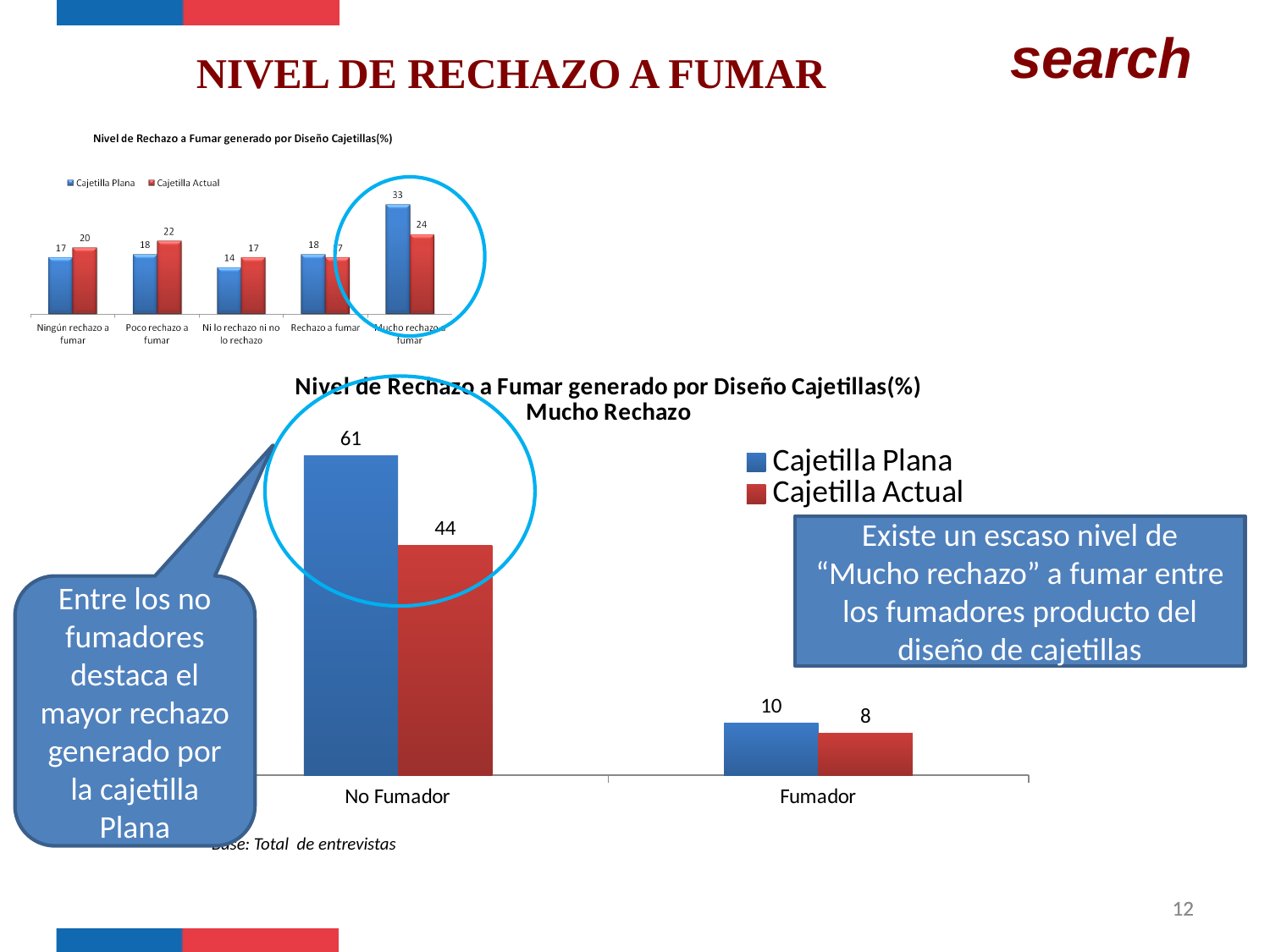
In the bottom chart (Mucho Rechazo), what is the value for Cajetilla Plana in the No Fumador category? 61 In the top chart, what is the value for Cajetilla Plana in the 'Mucho rechazo a fumar' category? 33 In the bottom chart (Mucho Rechazo), how many series does the legend list? 2 In the bottom chart (Mucho Rechazo), what is the value for Cajetilla Actual in the Fumador category? 8 In the top chart, what is the value for Cajetilla Actual in the 'Poco rechazo a fumar' category? 22 In the bottom chart (Mucho Rechazo), which category has the highest value for Cajetilla Plana? No Fumador In the top chart, which category has the lowest value for Cajetilla Plana? Ni lo rechazo ni no lo rechazo In the top chart, how many categories are shown on the x axis? 5 What kind of chart is the bottom chart (Mucho Rechazo)? Bar chart In the bottom chart (Mucho Rechazo), what is the difference between Cajetilla Plana and Cajetilla Actual for No Fumador? 17 In the top chart, which is larger for 'Ningún rechazo a fumar': Cajetilla Plana or Cajetilla Actual? Cajetilla Actual In the bottom chart (Mucho Rechazo), how many categories are shown on the x axis? 2